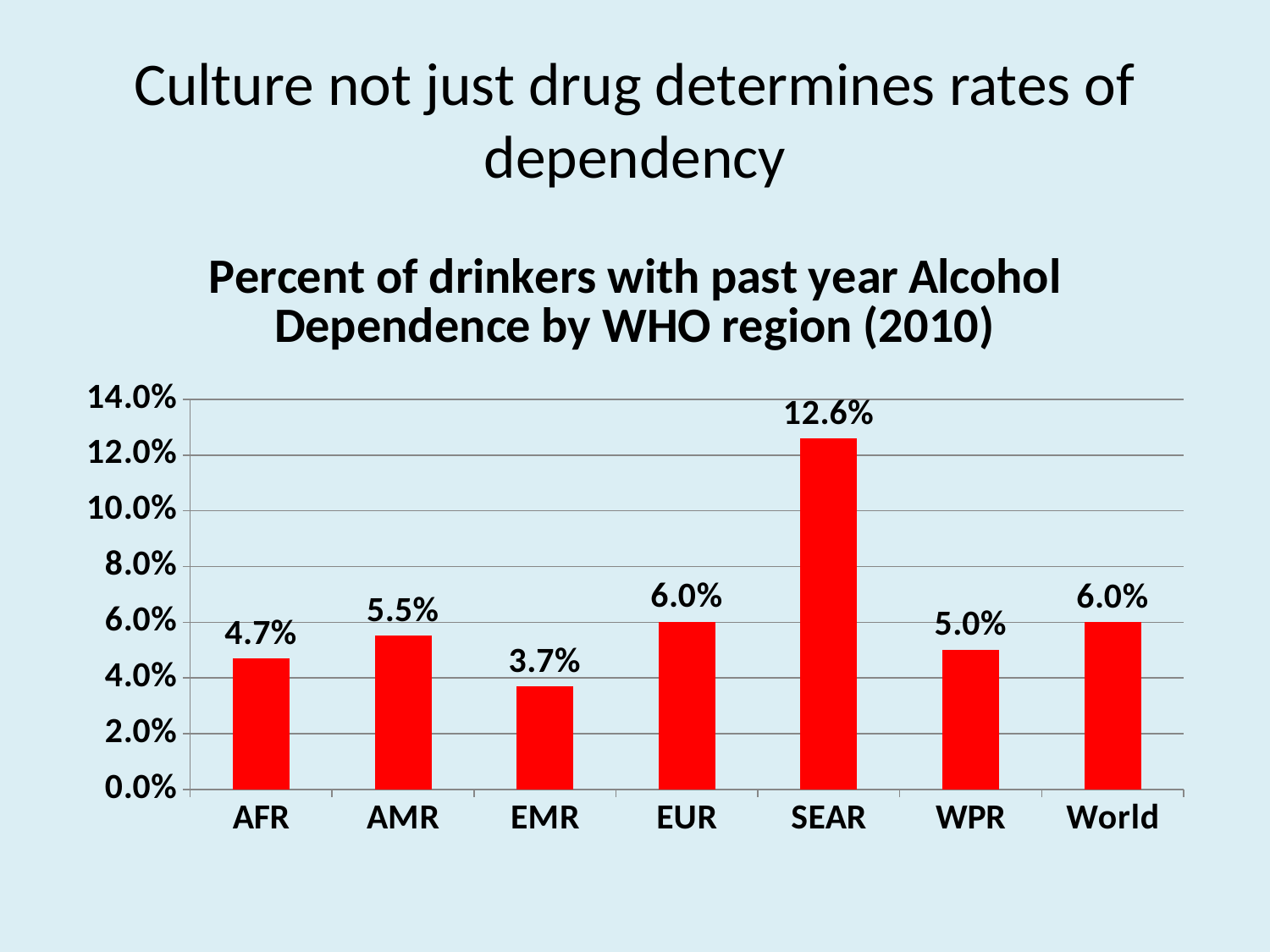
What is the value for SEAR? 12.6% How many categories are shown on the x axis? 7 Which region has the highest percent of drinkers with past year alcohol dependence? SEAR Which is larger, the value for AMR or the value for WPR? AMR What is the value for AFR? 4.7% What is the difference between the values for AMR and AFR? 0.8% Which region has the lowest percent of drinkers with past year alcohol dependence? EMR What is the value for WPR? 5.0% What kind of chart is shown on the slide? bar chart What is the difference between the values for SEAR and EMR? 8.9% What is the title of the chart? Percent of drinkers with past year Alcohol Dependence by WHO region (2010) Is the value for SEAR greater or less than 10.0%? greater